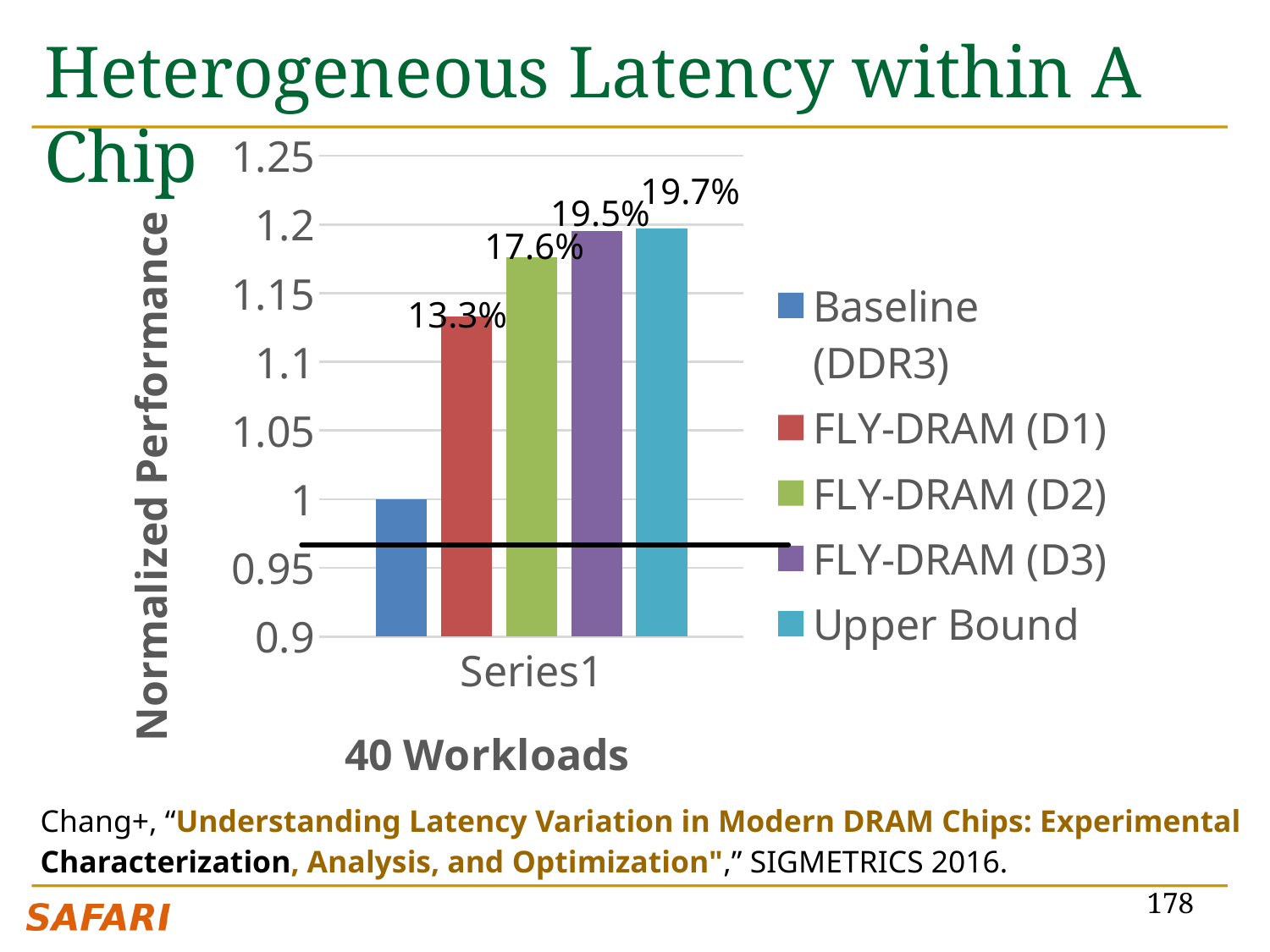
What is the data label on the FLY-DRAM (D3) bar? 19.5% What is the data label on the FLY-DRAM (D1) bar? 13.3% Is the value for FLY-DRAM (D3) greater or less than 1.15? greater Which series has the tallest bar? Upper Bound What is the data label on the Upper Bound bar? 19.7% What kind of chart is shown on the slide? bar chart Which is larger, the FLY-DRAM (D1) bar or the FLY-DRAM (D2) bar? FLY-DRAM (D2) What is the title of the y axis? Normalized Performance What is the data label on the FLY-DRAM (D2) bar? 17.6% Which series has the shortest bar? Baseline (DDR3) What normalized performance value does the Baseline (DDR3) bar reach on the y axis? 1 How many series does the legend list? 5